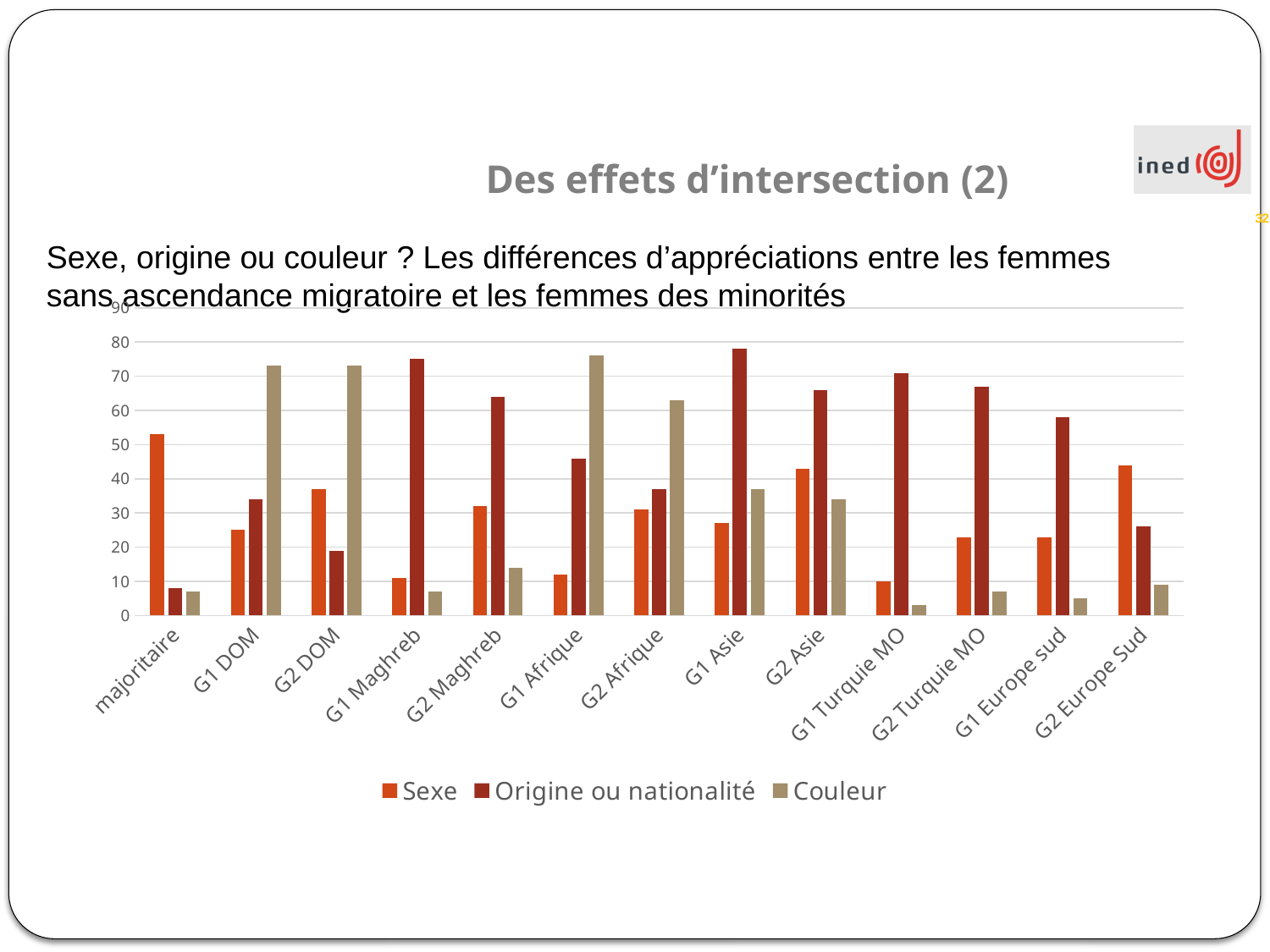
Is the Couleur value for G1 DOM greater or less than 70? greater For G1 Asie, which is larger: the Origine ou nationalité value or the Couleur value? Origine ou nationalité Which category has the lowest value for the Couleur series? G1 Turquie MO How many series does the legend list? 3 For G2 DOM, which is larger: the Sexe value or the Couleur value? Couleur Which category has the highest value for the Sexe series? majoritaire Is the Sexe value for G1 Maghreb greater or less than 20? less Which category has the lowest value for the Origine ou nationalité series? majoritaire Which series is shown in the lightest (beige) colour in the legend? Couleur What kind of chart is shown on the slide? bar chart Is the Sexe value for majoritaire greater or less than 50? greater How many categories are shown on the x axis? 13